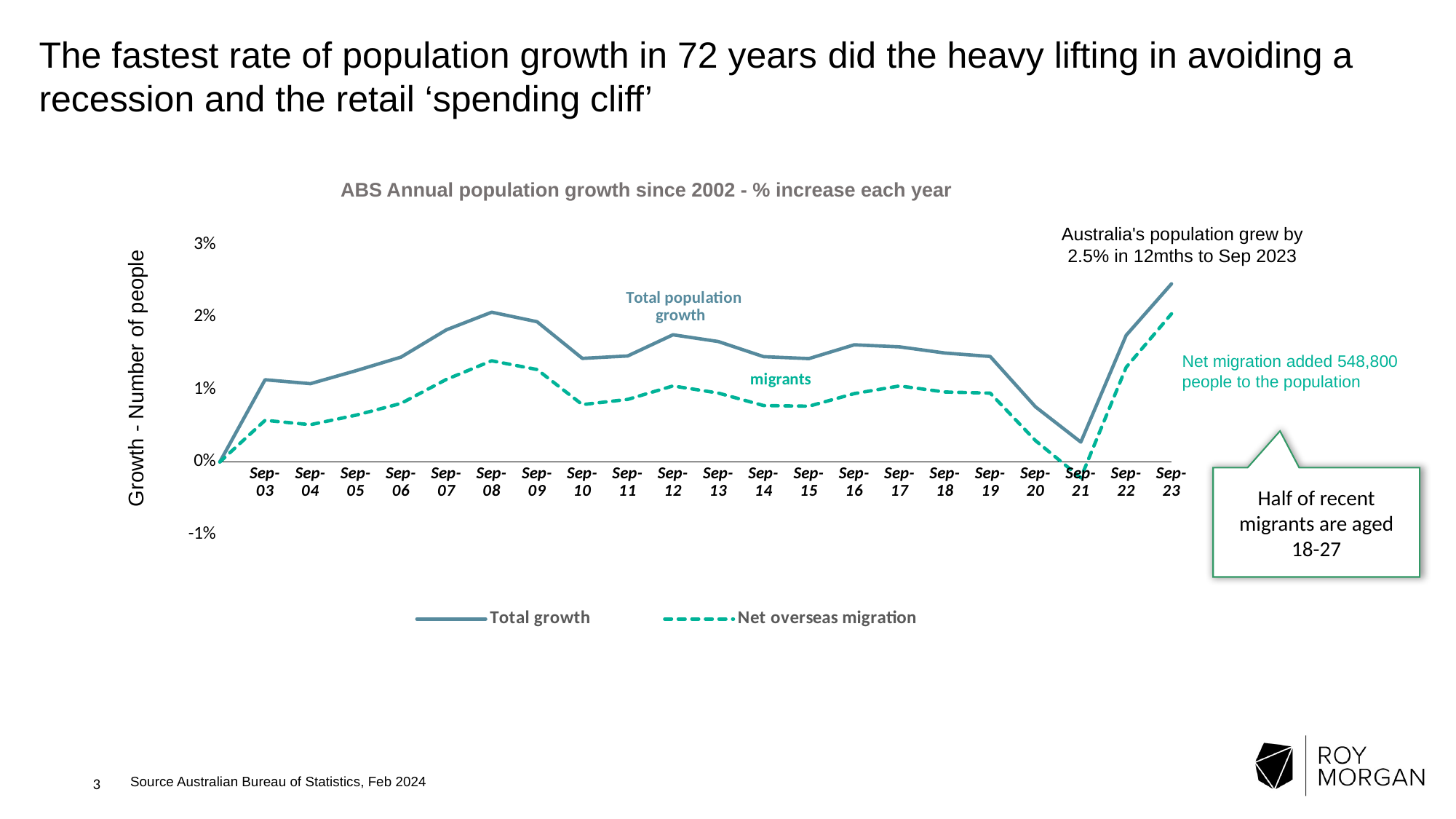
Is the Total growth value for Sep-20 greater or less than 1%? less What are the two series named in the chart legend? Total growth and Net overseas migration In which year does the Net overseas migration series reach its lowest value? Sep-21 Is the Net overseas migration value for Sep-21 greater or less than 0%? less In which year does the Total growth series reach its highest value? Sep-23 At Sep-12, which series has the higher value, Total growth or Net overseas migration? Total growth How many series does the chart legend list? 2 What kind of chart is shown on the slide? line chart According to the annotation on the chart, by how much did Australia's population grow in the 12 months to Sep 2023? 2.5% What is the title of the chart? ABS Annual population growth since 2002 - % increase each year Is the Total growth value for Sep-23 greater or less than 2%? greater How many labelled points are shown on the x axis (Sep-03 to Sep-23)? 21